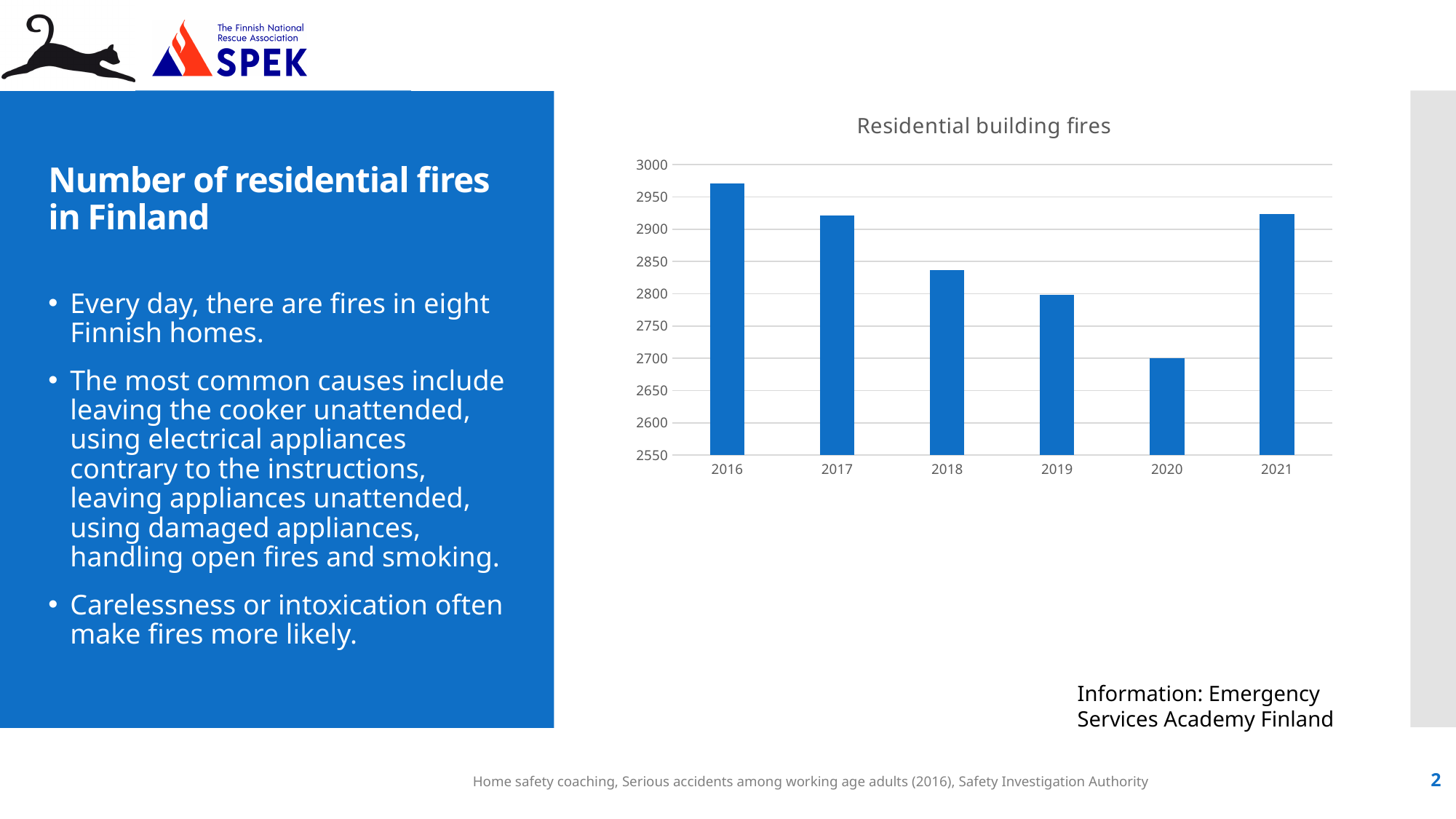
Is the value for 2020 greater or less than 2750? less Is the value for 2018 greater or less than 2850? less Which year has the highest number of residential building fires? 2016 Which year has more residential building fires, 2016 or 2018? 2016 Which year has more residential building fires, 2020 or 2021? 2021 How many years are shown on the x axis of the chart? 6 Which year has the lowest number of residential building fires? 2020 Is the value for 2016 greater or less than 2950? greater What kind of chart is shown on the slide? bar chart Do the values rise or fall from 2016 to 2020? fall What is the title of the chart? Residential building fires